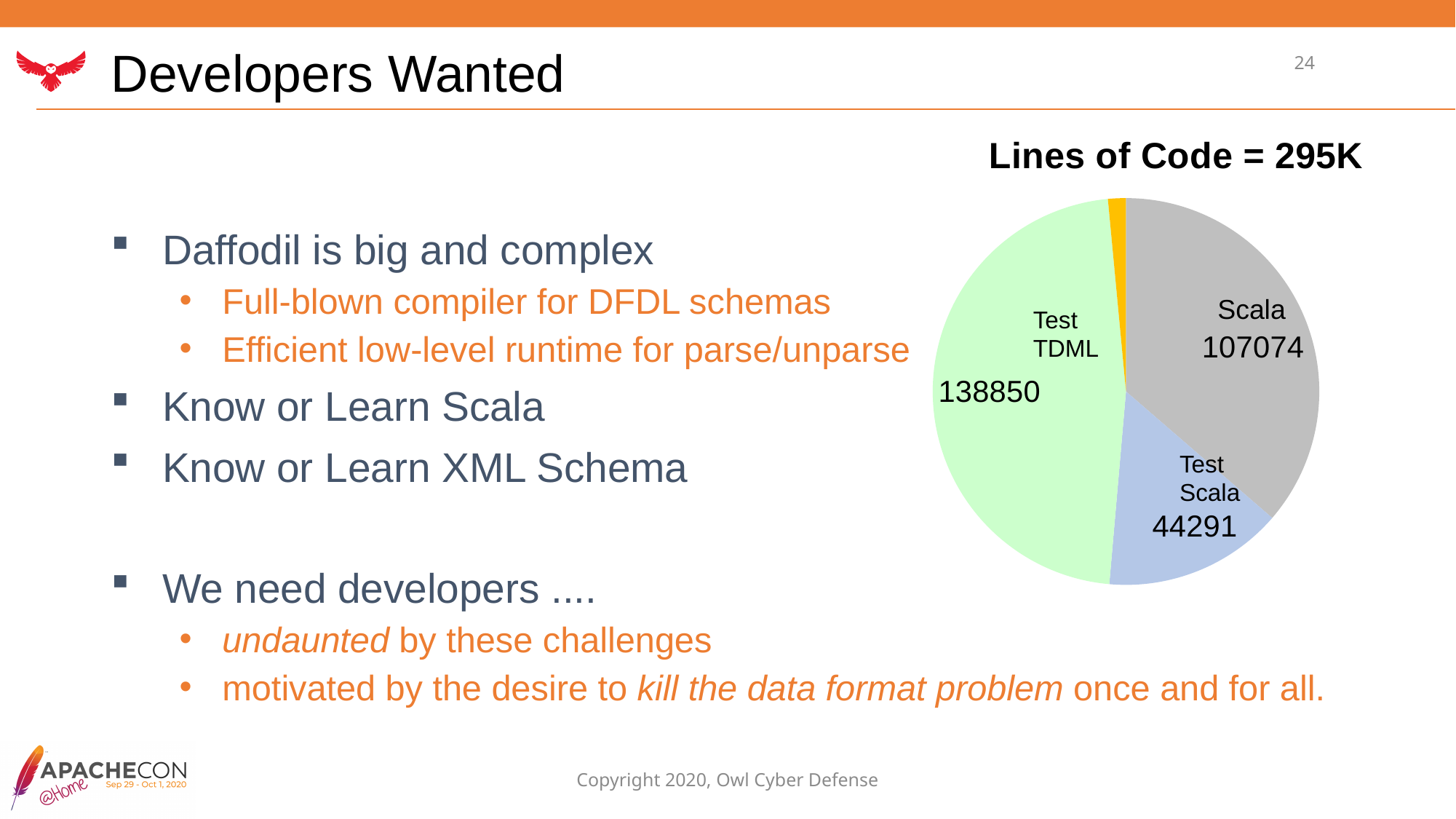
How many slices does the pie chart have? 4 What value is shown for the Test TDML slice? 138850 Which labeled slice of the pie is the largest? Test TDML Which is larger, Test TDML or Scala? Test TDML Which is larger, the Scala slice or the Test Scala slice? Scala What colour is the Test TDML slice? light green What is the title of the chart? Lines of Code = 295K What is the difference between the Test TDML value and the Scala value? 31776 What value is shown for the Test Scala slice? 44291 What is the difference between the Scala value and the Test Scala value? 62783 How many lines of code does the Scala slice show? 107074 What type of chart is shown on the slide? pie chart